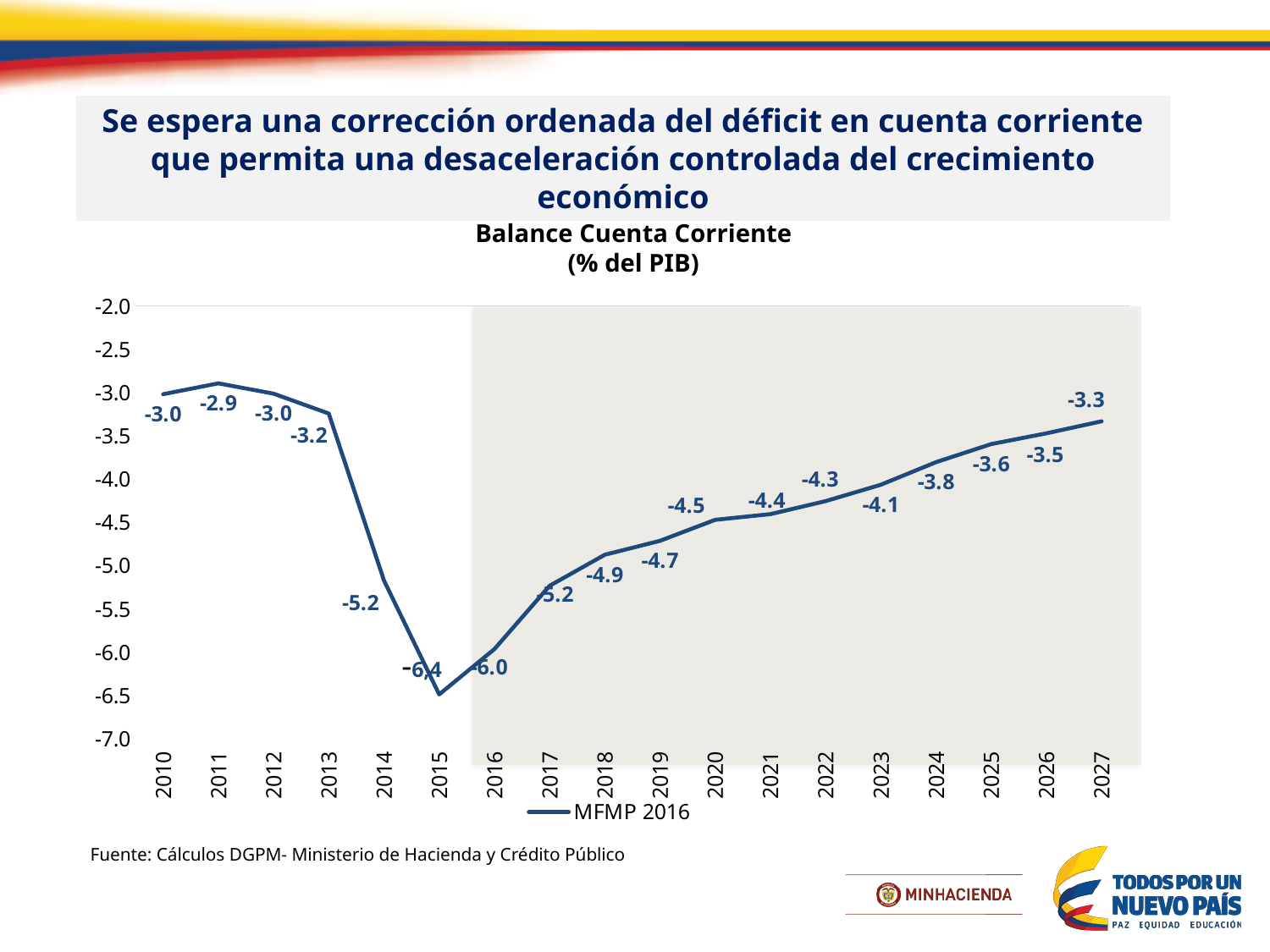
What is the value for 2015 in the Balance Cuenta Corriente chart? -6.5 How many years are plotted in the Balance Cuenta Corriente chart? 18 What is the value for 2027 in the Balance Cuenta Corriente chart? -3.3 What kind of chart is shown on the slide? Line chart What is the difference between the values for 2013 and 2014 in the Balance Cuenta Corriente chart? 2.0 Which year has the lowest value in the Balance Cuenta Corriente chart? 2015 How many series does the legend list? 1 Which is larger, the value for 2016 or the value for 2017? 2017 Which year has the highest value in the Balance Cuenta Corriente chart? 2011 What is the value for 2020 in the Balance Cuenta Corriente chart? -4.5 What is the difference between the values for 2027 and 2015 in the Balance Cuenta Corriente chart? 3.2 Do the values rise or fall from 2015 to 2027? Rise